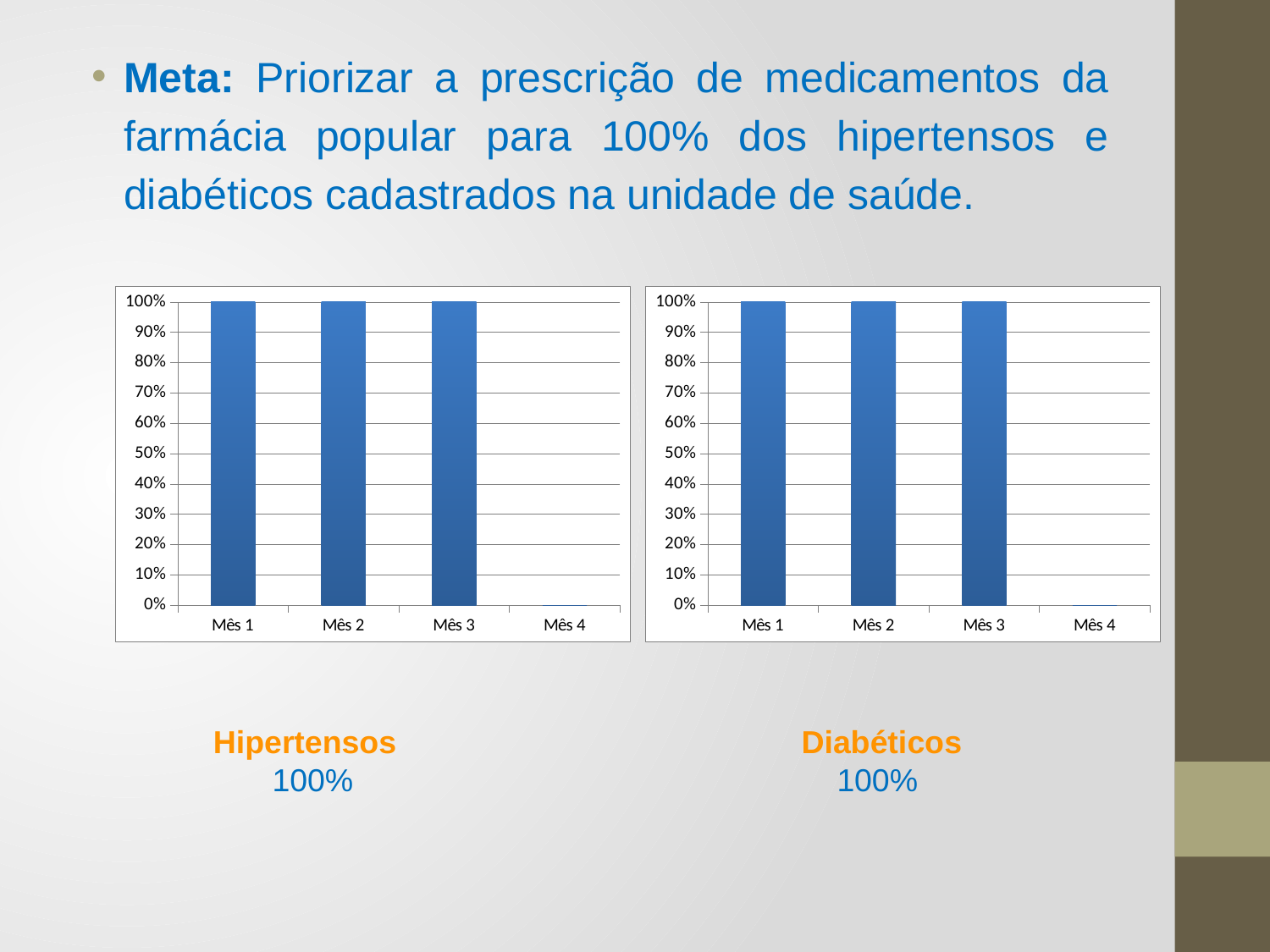
On the left chart (Hipertensos), what is the value for Mês 1? 100% On the left chart (Hipertensos), is the value for Mês 3 greater or less than 50%? greater On the right chart (Diabéticos), what is the value for Mês 1? 100% What kind of chart is the right chart (Diabéticos)? bar chart What kind of chart is the left chart (Hipertensos)? bar chart On the left chart (Hipertensos), what is the value for Mês 2? 100% How many categories are shown on the x axis of the left chart (Hipertensos)? 4 On the right chart (Diabéticos), is the value for Mês 2 greater or less than 90%? greater On the right chart (Diabéticos), what is the value for Mês 3? 100% How many charts are shown on the slide? 2 How many categories are shown on the x axis of the right chart (Diabéticos)? 4 On the left chart (Hipertensos), what is the difference between the values for Mês 1 and Mês 3? 0%